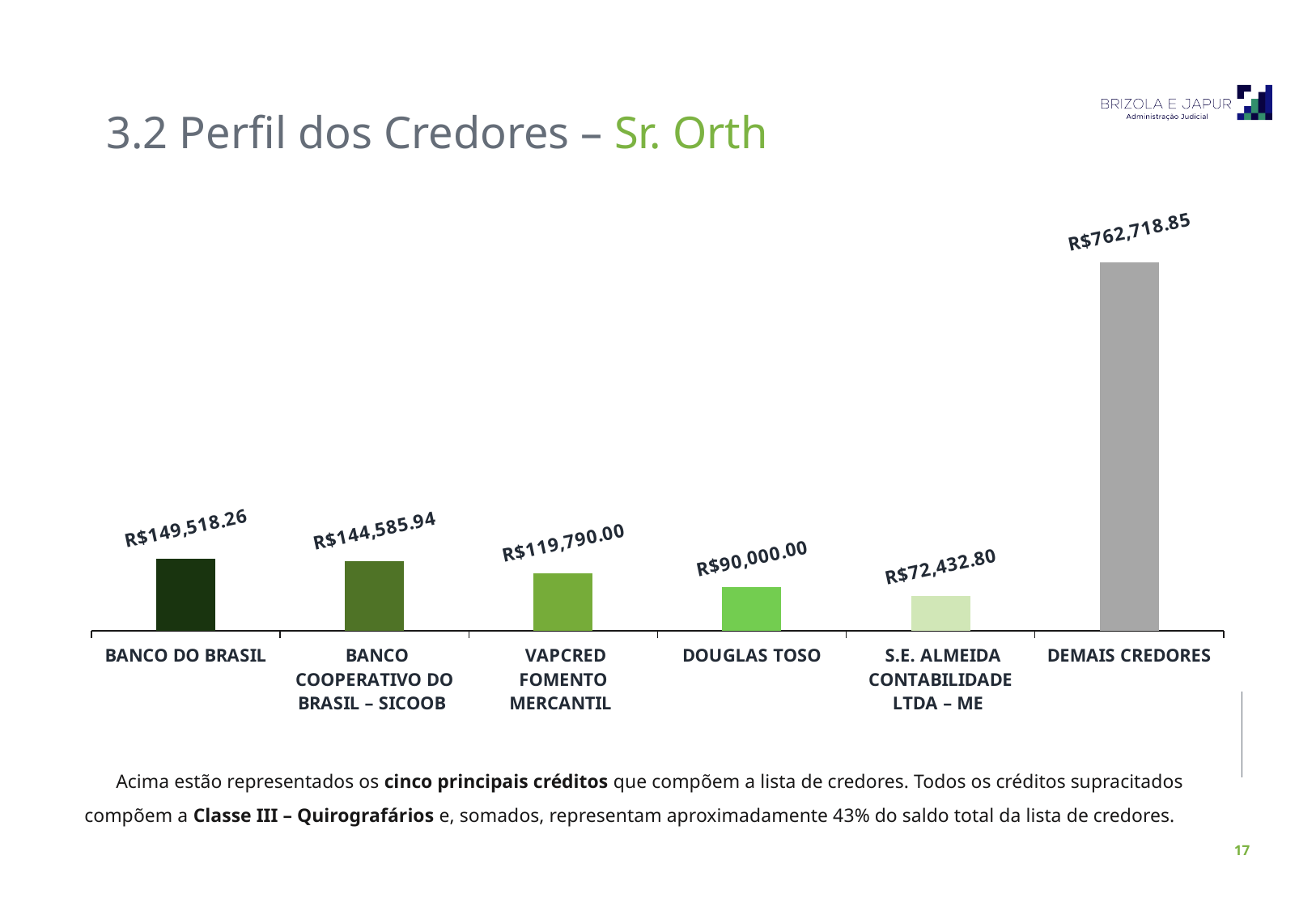
Which category has the lowest value in the chart? S.E. ALMEIDA CONTABILIDADE LTDA – ME What is the value shown for S.E. ALMEIDA CONTABILIDADE LTDA – ME? R$72,432.80 What kind of chart is shown on the slide? Bar chart What is the value shown for BANCO DO BRASIL? R$149,518.26 What is the value shown for DEMAIS CREDORES? R$762,718.85 Which is larger, the value for VAPCRED FOMENTO MERCANTIL or the value for DOUGLAS TOSO? VAPCRED FOMENTO MERCANTIL Which category has the highest value in the chart? DEMAIS CREDORES How many categories are shown in the chart? 6 What is the difference between the values for BANCO DO BRASIL and BANCO COOPERATIVO DO BRASIL – SICOOB? R$4,932.32 What is the difference between the values for VAPCRED FOMENTO MERCANTIL and DOUGLAS TOSO? R$29,790.00 What is the value shown for DOUGLAS TOSO? R$90,000.00 Do the values of the five named creditors rise or fall from left to right, before DEMAIS CREDORES? Fall